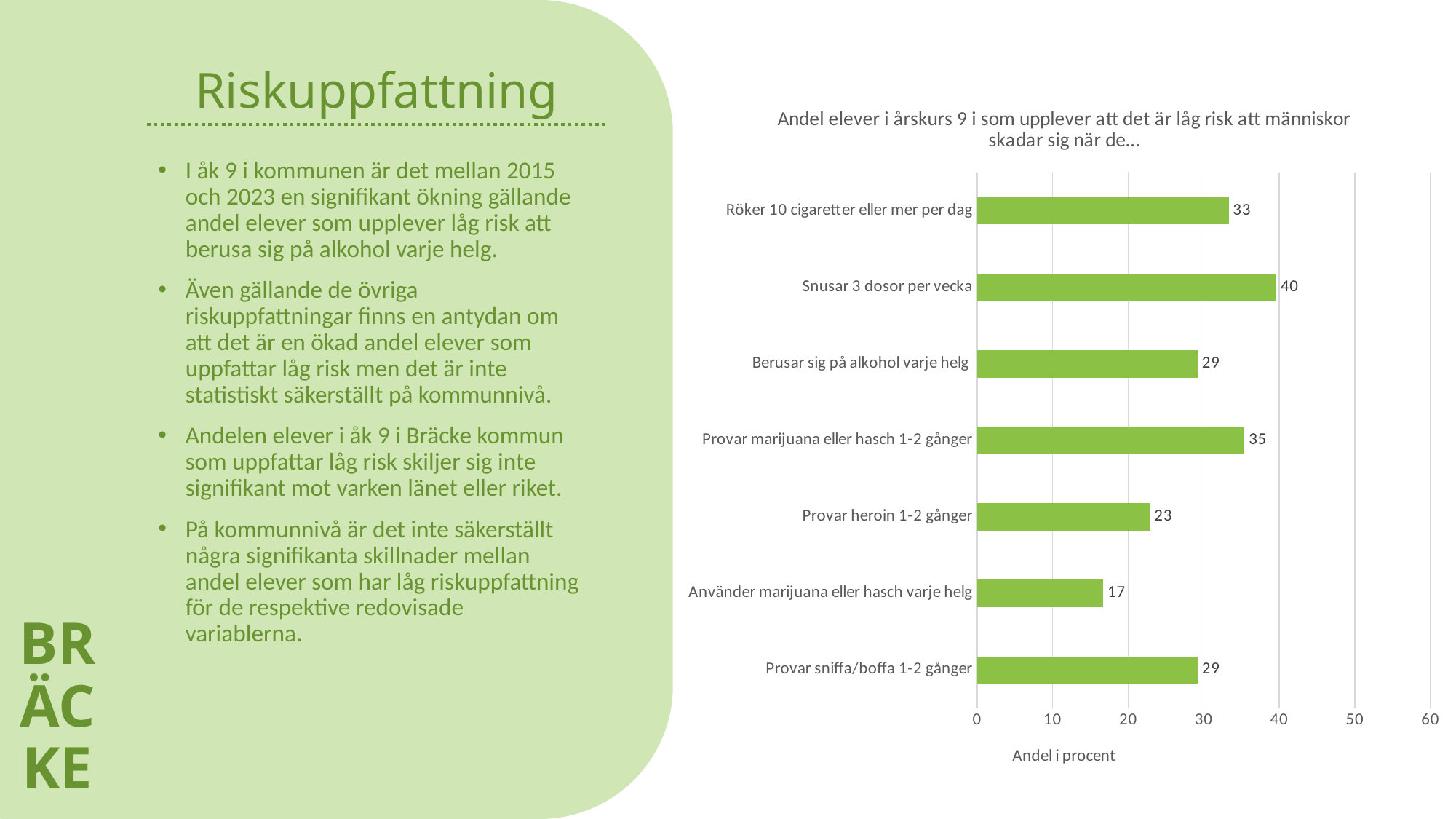
What is the value for "Använder marijuana eller hasch varje helg"? 17 Which is larger: the value for "Provar marijuana eller hasch 1-2 gånger" or the value for "Berusar sig på alkohol varje helg"? Provar marijuana eller hasch 1-2 gånger What is the label of the horizontal axis? Andel i procent What kind of chart is shown on the slide? Bar chart Which category has the highest value? Snusar 3 dosor per vecka How many categories are shown in the chart? 7 What is the value for "Provar heroin 1-2 gånger"? 23 Is the value for "Provar heroin 1-2 gånger" greater or less than 30? less Which category has the lowest value? Använder marijuana eller hasch varje helg What is the value for "Snusar 3 dosor per vecka"? 40 What is the value for "Provar sniffa/boffa 1-2 gånger"? 29 What is the difference between the values for "Snusar 3 dosor per vecka" and "Röker 10 cigaretter eller mer per dag"? 7